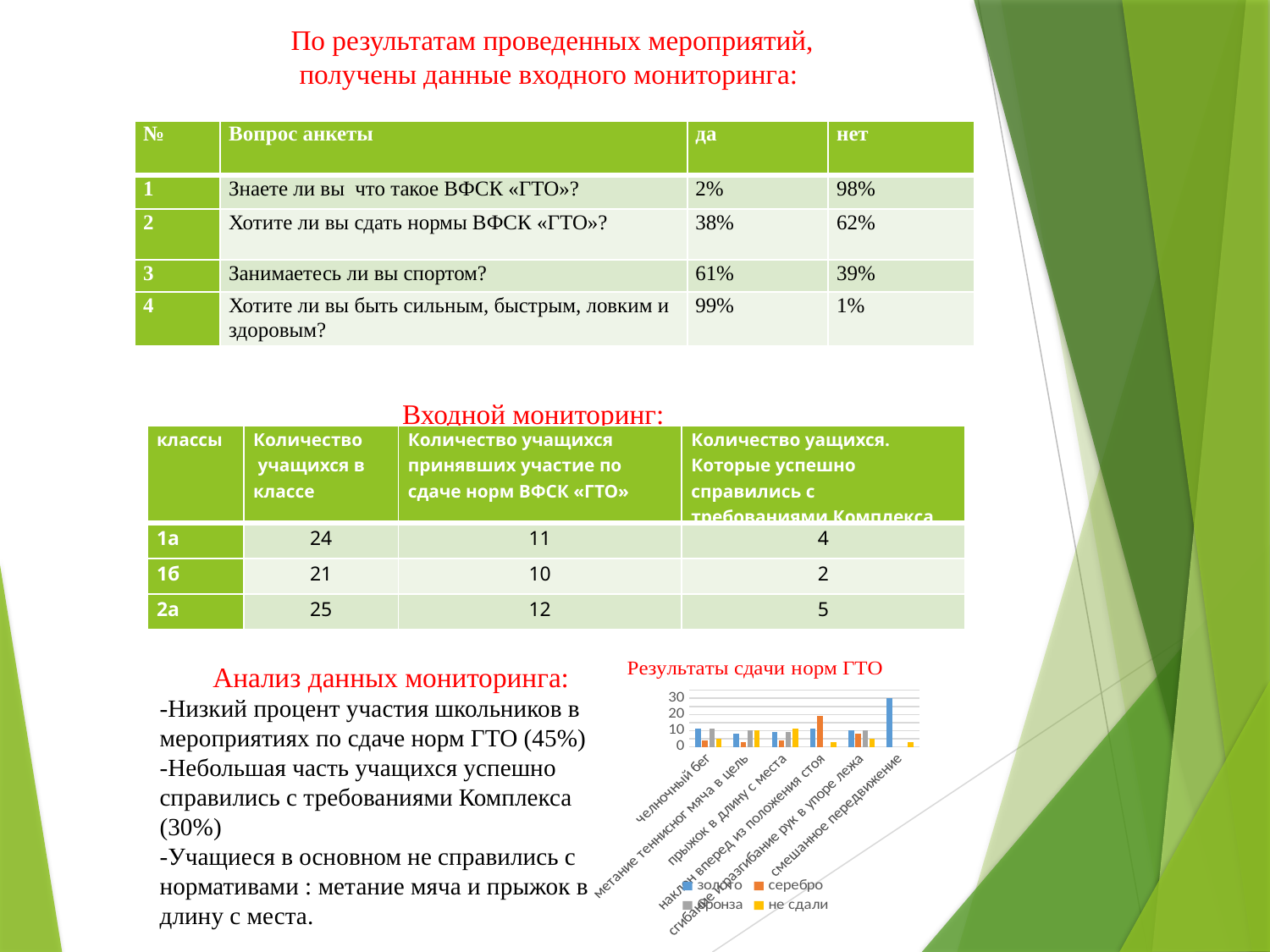
In the "Результаты сдачи норм ГТО" chart, which category contains the tallest bar? смешанное передвижение What is the title of the chart on the slide? Результаты сдачи норм ГТО How many series does the legend of the "Результаты сдачи норм ГТО" chart list? 4 What kind of chart is "Результаты сдачи норм ГТО"? bar chart In the "Результаты сдачи норм ГТО" chart, is the value for золото in смешанное передвижение greater or less than 20? greater What are the legend entries of the "Результаты сдачи норм ГТО" chart? золото, серебро, бронза, не сдали In the "Результаты сдачи норм ГТО" chart, which is larger: золото in смешанное передвижение or серебро in наклон вперед из положения стоя? золото in смешанное передвижение In the "Результаты сдачи норм ГТО" chart, is the value for не сдали in смешанное передвижение greater or less than 10? less How many categories are shown on the x axis of the "Результаты сдачи норм ГТО" chart? 6 In the "Результаты сдачи норм ГТО" chart, what is the highest value shown on the vertical axis? 30 In the "Результаты сдачи норм ГТО" chart, which series has the tallest bar overall? золото